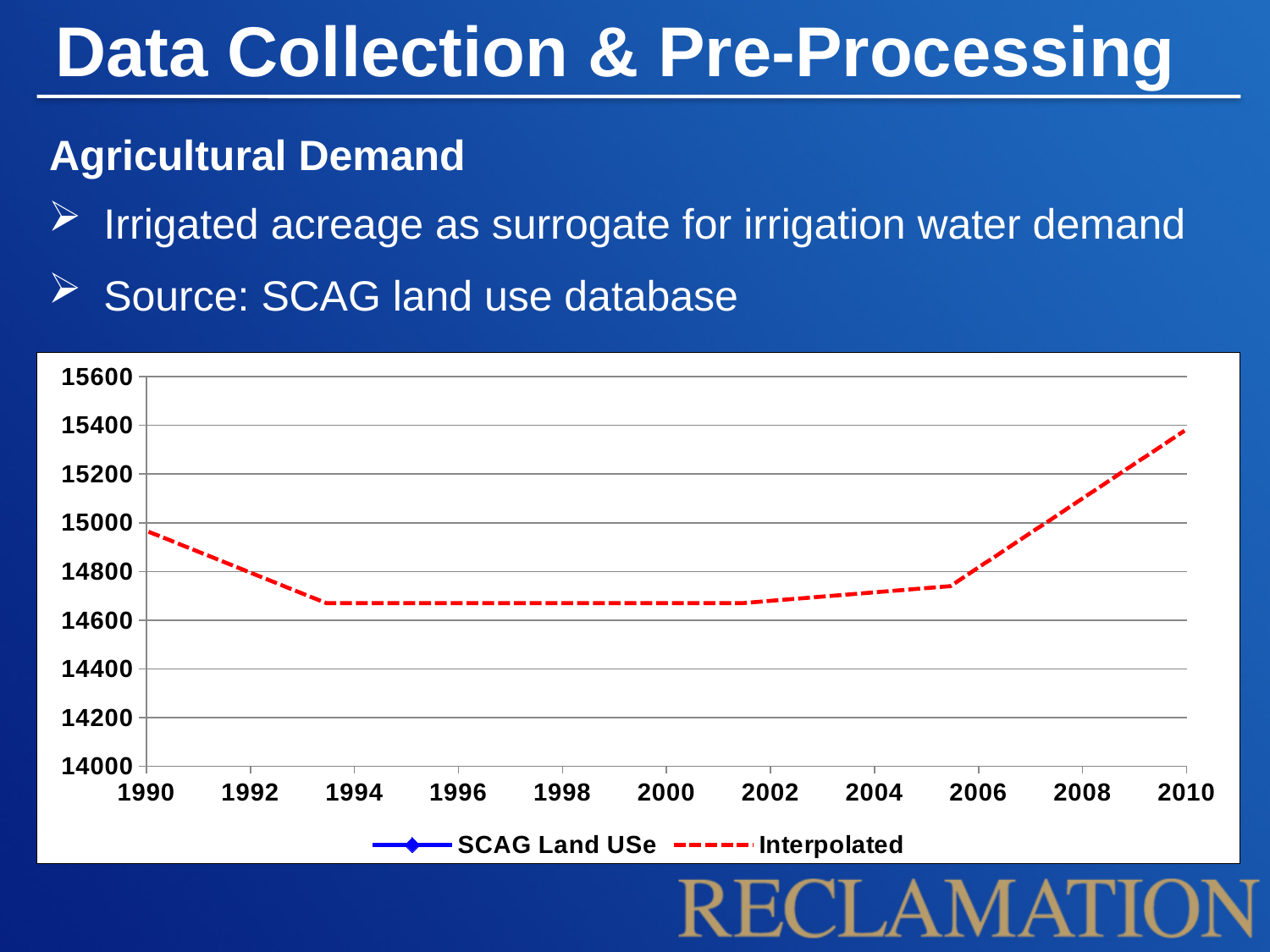
Is the Interpolated value for 1990 greater or less than 14800? greater Is the Interpolated value for 2008 greater or less than 15000? greater What colour and line style is used for the Interpolated series? red dashed line What kind of chart is shown on the slide? line chart How many series does the chart legend list? 2 Is the Interpolated value for 2000 greater or less than 14800? less Which is larger, the Interpolated value for 1990 or for 2000? 1990 Does the Interpolated line rise or fall between 2006 and 2010? rise Which year has the highest Interpolated value on the chart? 2010 What are the two series named in the chart legend? SCAG Land USe and Interpolated